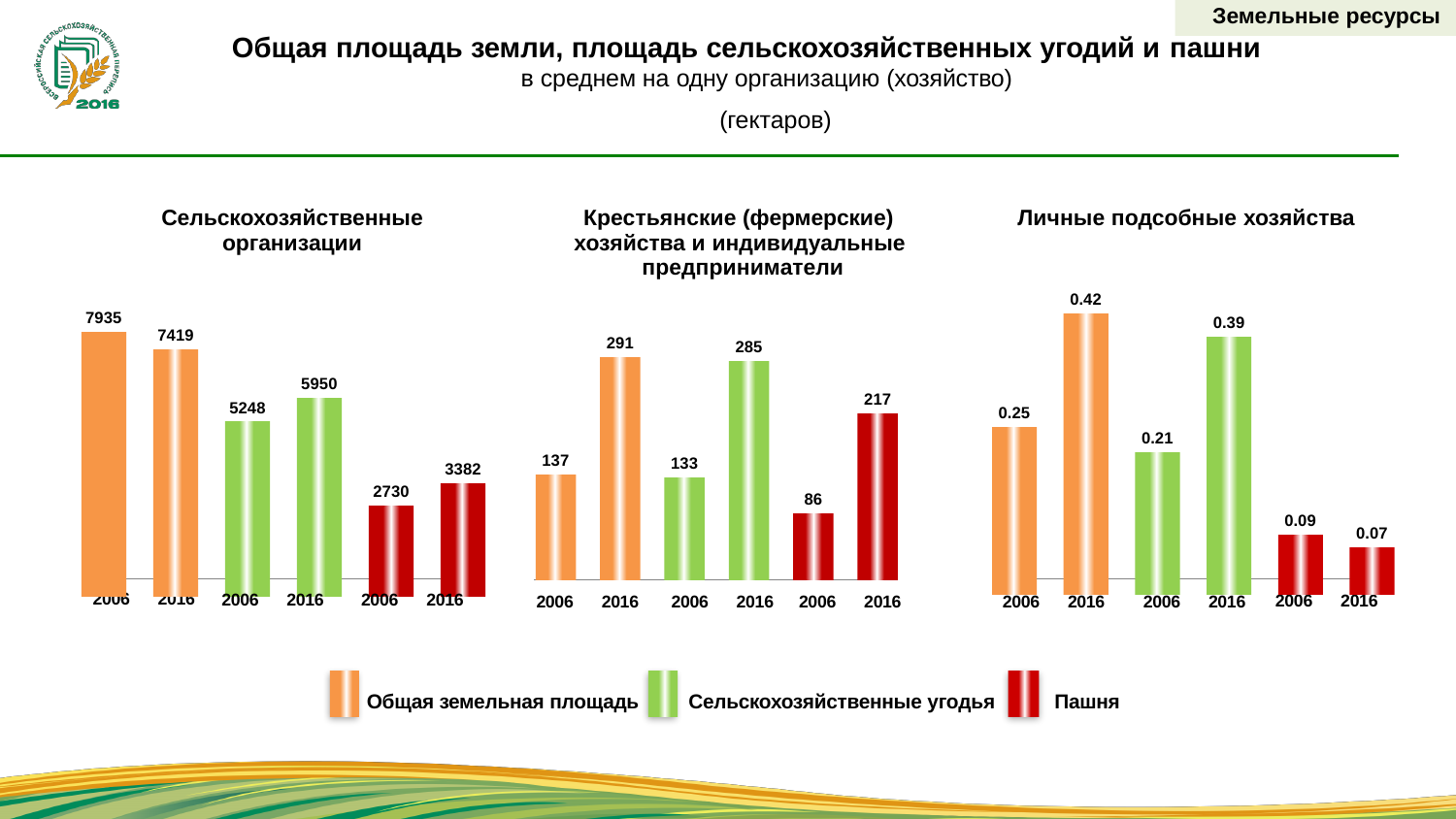
On the chart titled 'Крестьянские (фермерские) хозяйства и индивидуальные предприниматели', what is the difference between Пашня in 2016 and in 2006? 131 On the chart titled 'Личные подсобные хозяйства', which bar is the highest? Общая земельная площадь 2016 (0.42) How many series does the shared legend list? 3 On the chart titled 'Личные подсобные хозяйства', what is the value of Сельскохозяйственные угодья for 2016? 0.39 On the chart titled 'Сельскохозяйственные организации', did Общая земельная площадь rise or fall from 2006 to 2016? fall On the chart titled 'Сельскохозяйственные организации', what is the difference between Сельскохозяйственные угодья in 2016 and in 2006? 702 On the chart titled 'Сельскохозяйственные организации', what is the value of Общая земельная площадь for 2006? 7935 On the chart titled 'Сельскохозяйственные организации', what is the value of Пашня for 2016? 3382 On the chart titled 'Крестьянские (фермерские) хозяйства и индивидуальные предприниматели', which bar is the lowest? Пашня 2006 (86) On the chart titled 'Крестьянские (фермерские) хозяйства и индивидуальные предприниматели', what is the value of Общая земельная площадь for 2016? 291 What type of chart is the chart titled 'Личные подсобные хозяйства'? bar chart On the chart titled 'Личные подсобные хозяйства', which is larger: Пашня in 2006 or Пашня in 2016? 2006